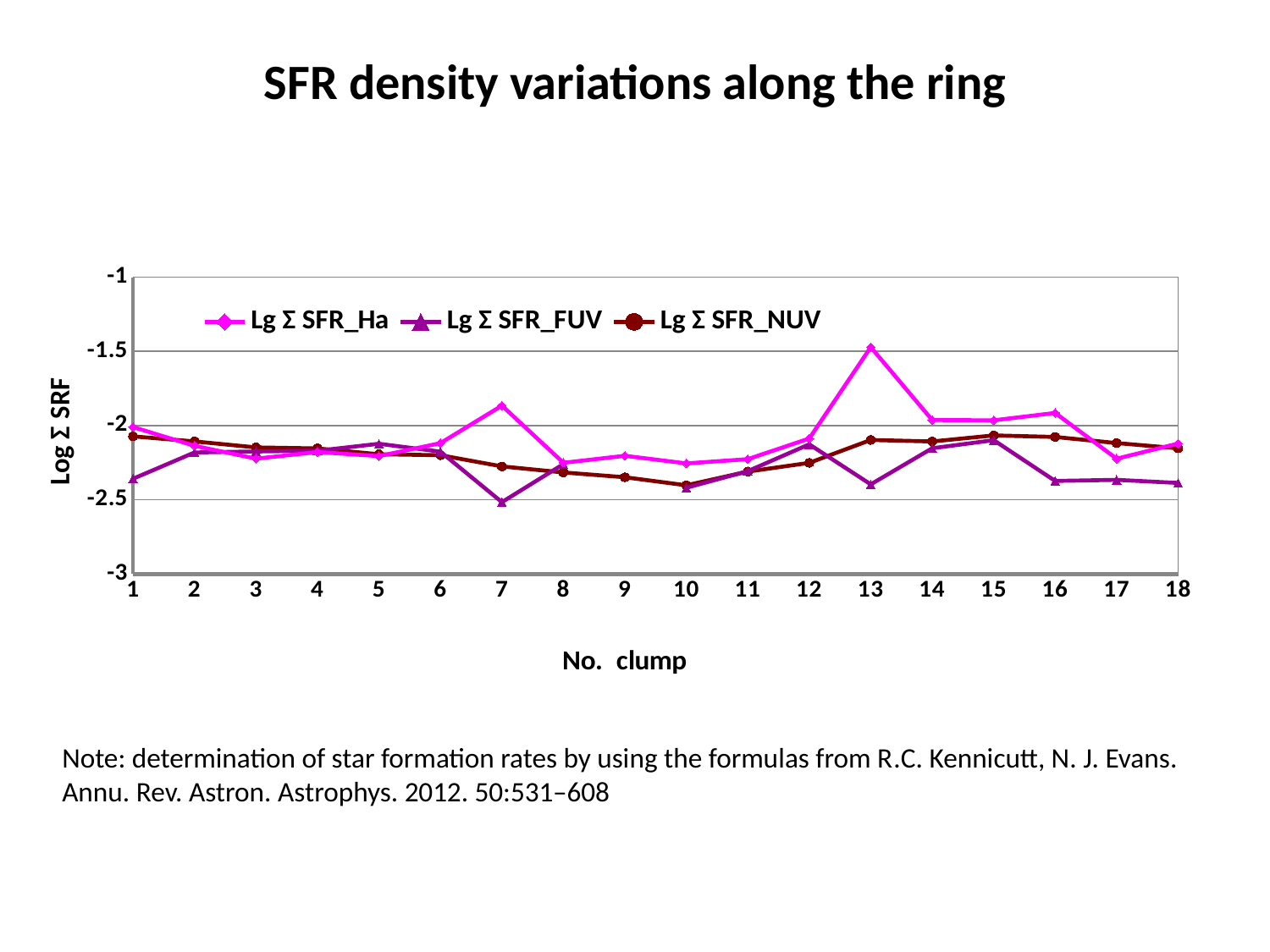
Is the Lg Σ SFR_Ha value at clump 13 greater or less than -2? greater At which clump number does the Lg Σ SFR_FUV series reach its lowest value? 7 Is the Lg Σ SFR_NUV value at clump 10 greater or less than -2? less At which clump number does the Lg Σ SFR_Ha series reach its highest value? 13 What is the label of the x axis? No. clump What kind of chart is shown on the slide? Line chart Which series reaches the highest value anywhere on the chart? Lg Σ SFR_Ha At clump 16, which series has the larger value, Lg Σ SFR_NUV or Lg Σ SFR_FUV? Lg Σ SFR_NUV Is the Lg Σ SFR_FUV value at clump 7 greater or less than -2? less How many series does the legend list? 3 At clump 13, which series has the larger value, Lg Σ SFR_Ha or Lg Σ SFR_FUV? Lg Σ SFR_Ha How many clumps are plotted along the x axis? 18